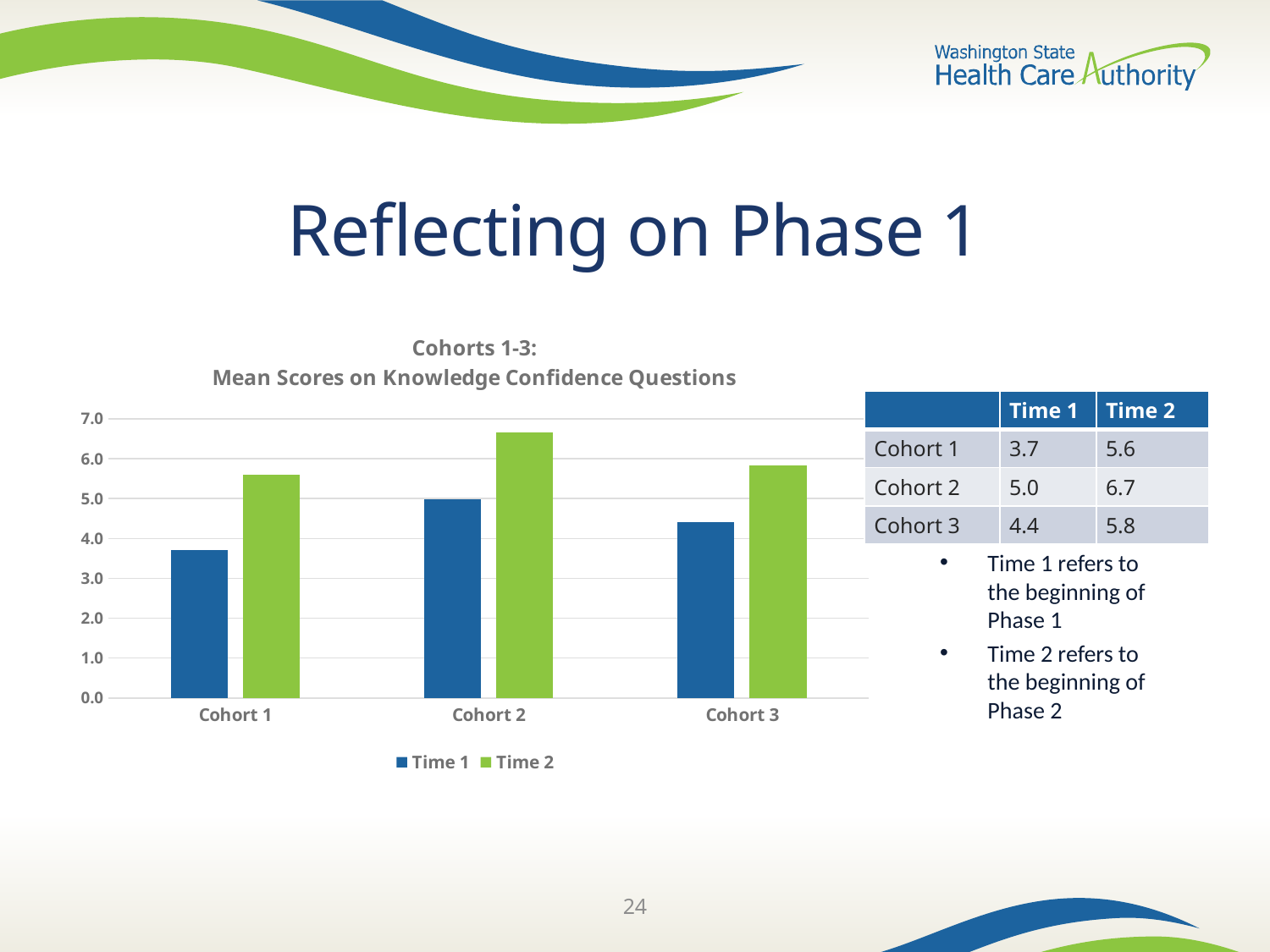
What type of chart is shown on the slide? bar chart Is the Time 2 mean score for Cohort 2 greater or less than 6.0? greater What is the Time 1 mean score for Cohort 3? 4.4 What is the difference between the Time 2 and Time 1 mean scores for Cohort 1? 1.9 Which is larger, the Time 1 score for Cohort 3 or the Time 1 score for Cohort 2? Cohort 2 Which cohort has the highest Time 2 mean score? Cohort 2 What is the Time 2 mean score for Cohort 1? 5.6 How many cohorts are shown on the x axis of the chart? 3 Which cohort has the lowest Time 1 mean score? Cohort 1 What is the Time 1 mean score for Cohort 2? 5.0 How many series does the chart legend list? 2 What is the title of the chart? Cohorts 1-3: Mean Scores on Knowledge Confidence Questions